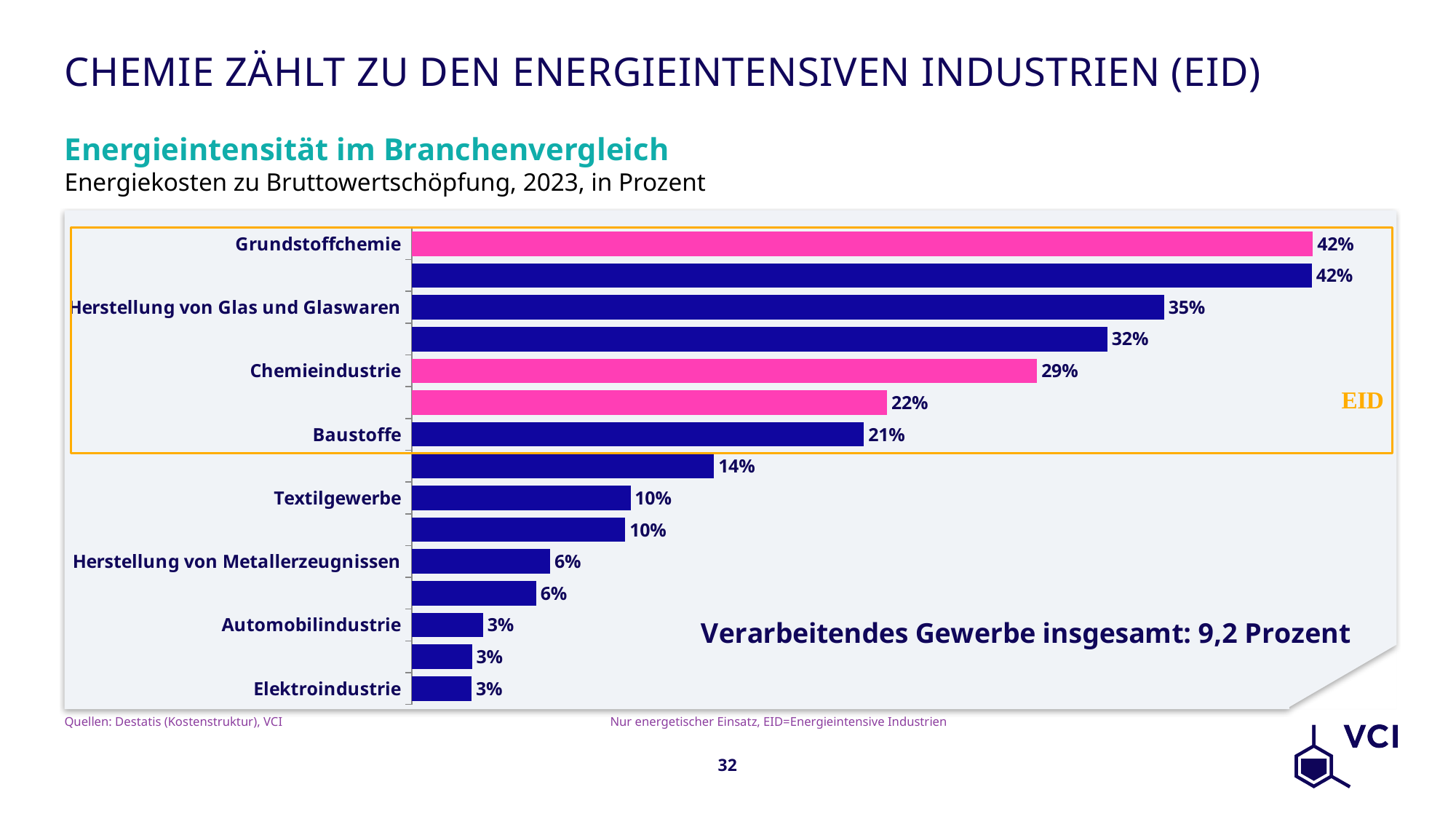
What is the value for Chemieindustrie? 29% What is the value for Grundstoffchemie? 42% How many bars are plotted in the chart? 15 What is the value for Herstellung von Glas und Glaswaren? 35% What value does the chart give for Verarbeitendes Gewerbe insgesamt? 9,2 Prozent What is the value for Elektroindustrie? 3% What is the value for Textilgewerbe? 10% What is the value for Baustoffe? 21% What is the difference between the values for Textilgewerbe and Automobilindustrie? 7% What kind of chart is shown on the slide? bar chart What is the difference between the values for Grundstoffchemie and Chemieindustrie? 13% Which is larger, the value for Chemieindustrie or the value for Baustoffe? Chemieindustrie